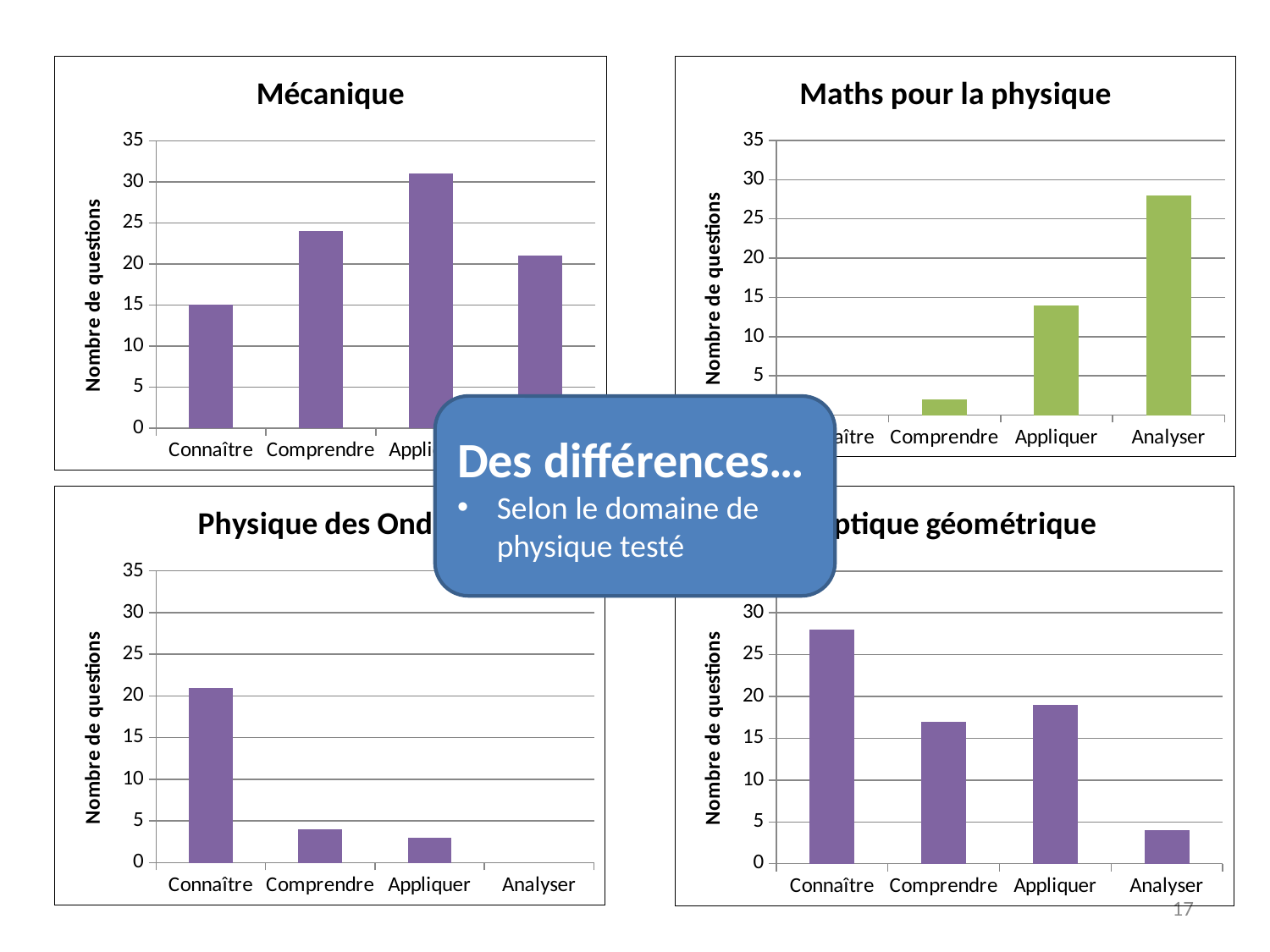
In the bottom-right chart, is the value for Connaître greater or less than 25? greater In the "Maths pour la physique" chart, is the value for Comprendre greater or less than 5? less In the bottom-left chart, is the value for Connaître greater or less than 20? greater In the "Maths pour la physique" chart, which category has the highest number of questions? Analyser In the bottom-right chart, which category has the lowest number of questions? Analyser In the "Mécanique" chart, which category has the highest number of questions? Appliquer What kind of chart is the "Mécanique" chart? bar chart In the "Maths pour la physique" chart, which is larger, Appliquer or Analyser? Analyser What is the y-axis label of the "Mécanique" chart? Nombre de questions In the bottom-left chart, which category has the highest number of questions? Connaître In the "Mécanique" chart, what is the value for Connaître? 15